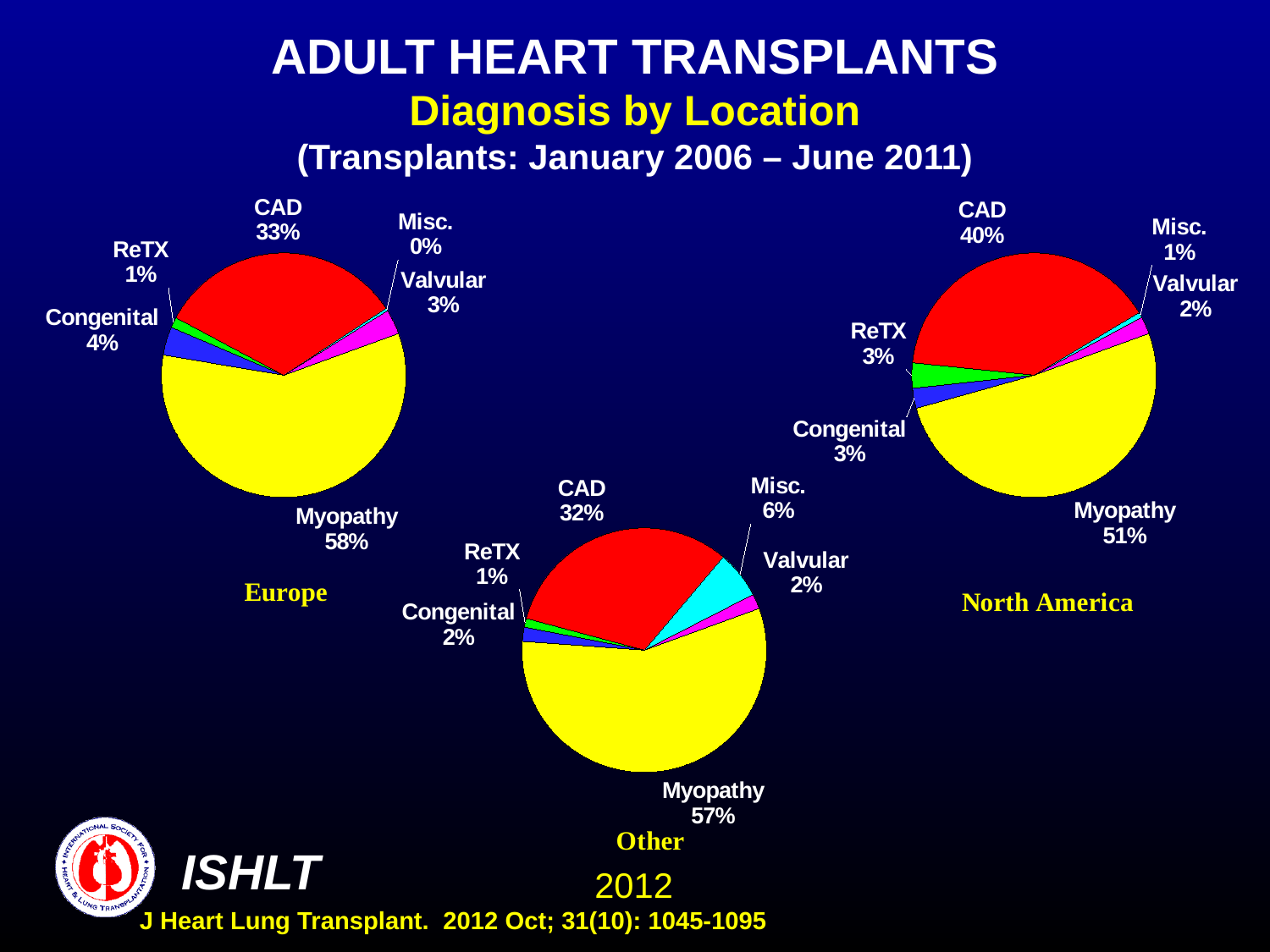
In the North America pie chart, what percentage is Congenital? 3% In the Europe pie chart, what percentage is Myopathy? 58% Is the CAD share larger in the Europe pie chart or the North America pie chart? North America What colour is the Myopathy slice in each pie chart? Yellow In the Europe pie chart, which diagnosis has the smallest share? Misc. In the North America pie chart, what is the difference between the Myopathy and CAD percentages? 11% In the Europe pie chart, which diagnosis has the largest share? Myopathy How many slices does the Other pie chart have? 6 In the Other pie chart, what percentage is Misc.? 6% What kind of charts are shown on the slide? Pie charts In the North America pie chart, what percentage is CAD? 40% In the Other pie chart, what is the combined share of CAD and Myopathy? 89%